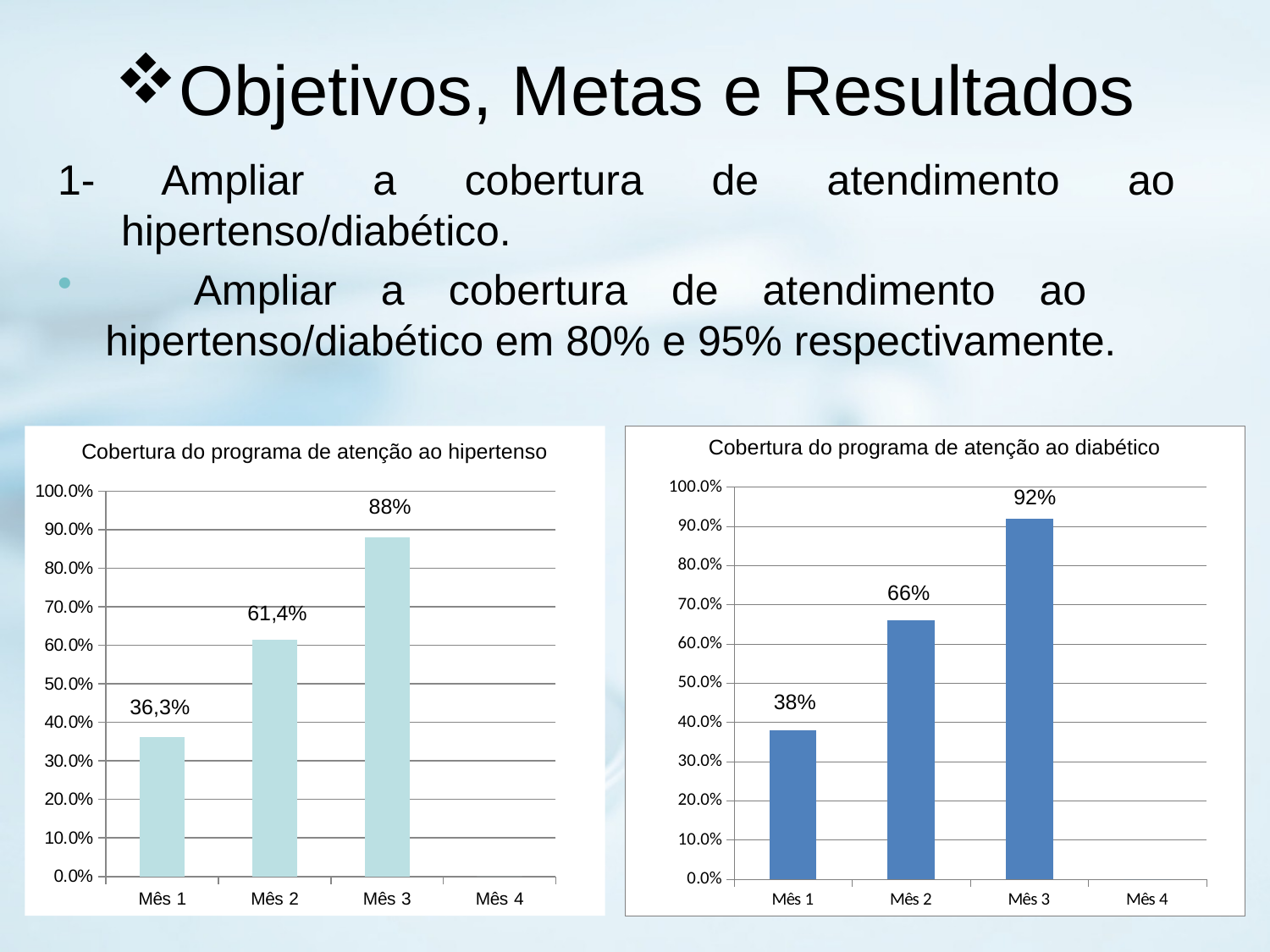
In the chart 'Cobertura do programa de atenção ao diabético', what is the difference between the values for Mês 3 and Mês 1? 54 percentage points In the chart 'Cobertura do programa de atenção ao hipertenso', what is the value for Mês 1? 36,3% In the chart 'Cobertura do programa de atenção ao hipertenso', what is the value for Mês 2? 61,4% In the chart 'Cobertura do programa de atenção ao hipertenso', which month has the highest value? Mês 3 Which is larger: the Mês 2 value in the hipertenso chart or the Mês 2 value in the diabético chart? The Mês 2 value in the diabético chart (66%) In the chart 'Cobertura do programa de atenção ao diabético', what is the value for Mês 1? 38% In the chart 'Cobertura do programa de atenção ao hipertenso', what is the difference between the values for Mês 3 and Mês 1? 51,7 percentage points In the chart 'Cobertura do programa de atenção ao diabético', what is the value for Mês 3? 92% In the chart 'Cobertura do programa de atenção ao diabético', is the value for Mês 2 greater or less than 70.0%? less What kind of chart is 'Cobertura do programa de atenção ao diabético'? Bar chart In the chart 'Cobertura do programa de atenção ao diabético', which month with a plotted bar has the lowest value? Mês 1 How many month categories are shown on the x axis of the chart 'Cobertura do programa de atenção ao hipertenso'? 4